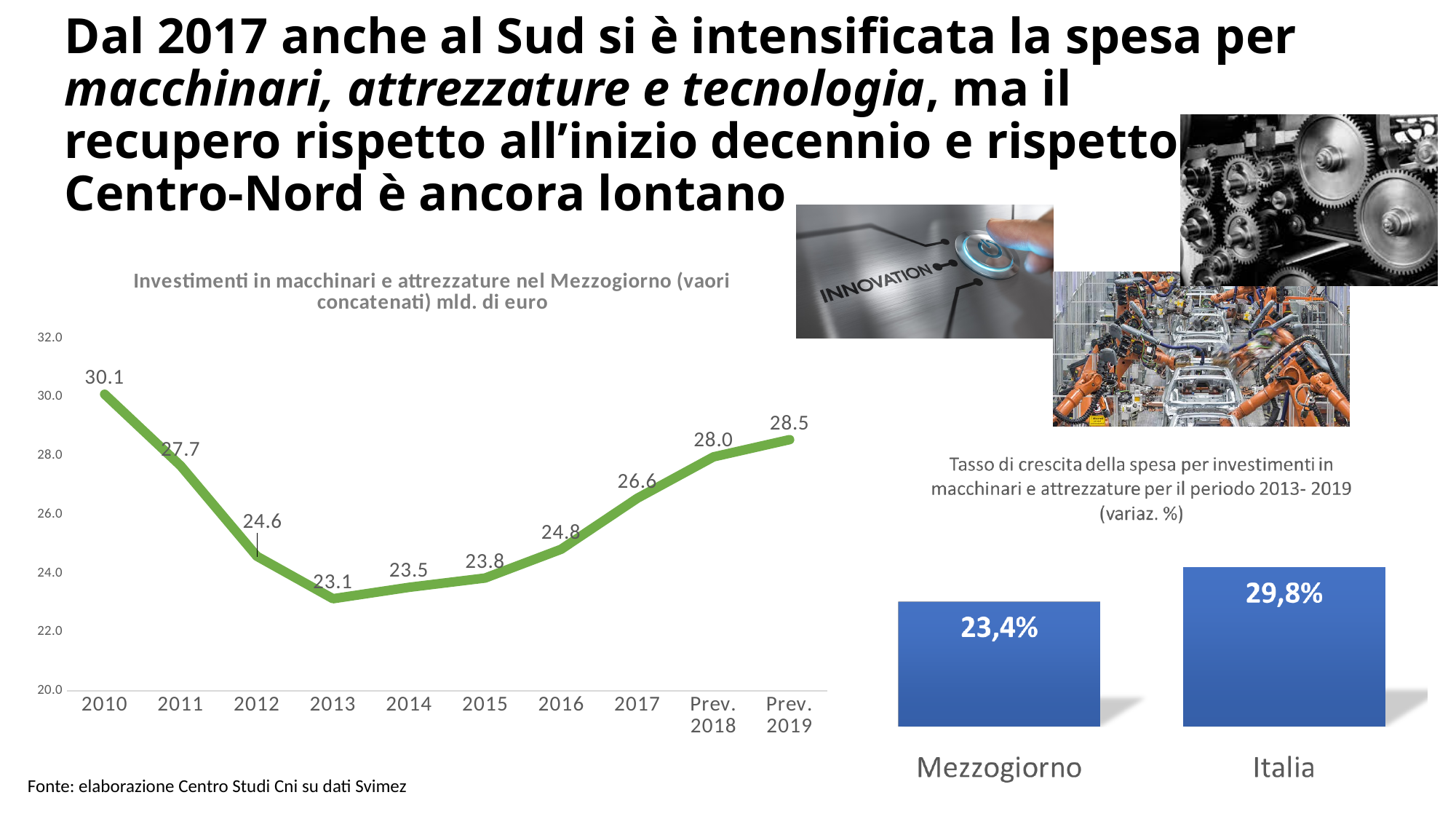
In the line chart on the left, what is the value for 2010? 30.1 In the line chart on the left, do the values rise or fall from 2013 to Prev. 2019? rise In the bar chart on the right, what is the difference between the values for Italia and Mezzogiorno? 6,4% In the line chart on the left, how many data points are plotted? 10 In the line chart on the left, which year has the lowest value? 2013 In the bar chart on the right, which is larger, Mezzogiorno or Italia? Italia In the line chart on the left, which year has the highest value? 2010 In the line chart on the left, what is the value for Prev. 2019? 28.5 In the line chart on the left, what is the difference between the values for 2017 and 2016? 1.8 In the bar chart on the right, what is the value for Mezzogiorno? 23,4% In the line chart on the left, what is the value for 2013? 23.1 What kind of chart is the chart on the left? line chart